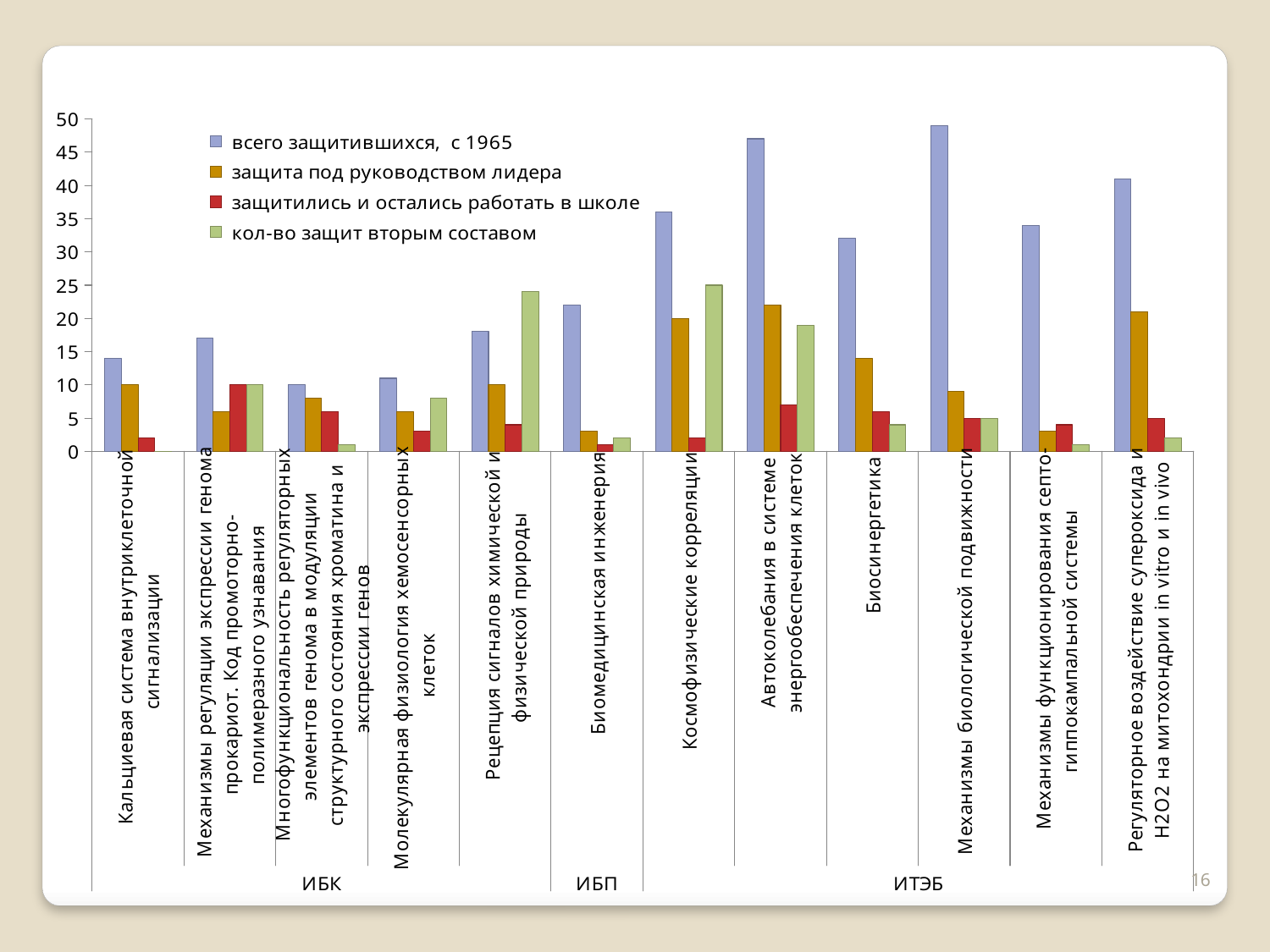
How many categories (research topics) are plotted along the x axis? 12 What is the first series listed in the legend? всего защитившихся, с 1965 Which institute groups are labelled along the bottom of the x axis? ИБК, ИБП, ИТЭБ What kind of chart is shown on the slide? bar chart Which category has the larger value of 'всего защитившихся, с 1965': Космофизические корреляции or Биосинергетика? Космофизические корреляции Is the value of 'всего защитившихся, с 1965' for Биомедицинская инженерия greater or less than 20? greater Which is larger for Рецепция сигналов химической и физической природы: 'защита под руководством лидера' or 'кол-во защит вторым составом'? кол-во защит вторым составом How many series does the legend list? 4 Which category has the larger value of 'защита под руководством лидера': Космофизические корреляции or Биосинергетика? Космофизические корреляции Is the value of 'всего защитившихся, с 1965' for Автоколебания в системе энергообеспечения клеток greater or less than 45? greater Is the value of 'всего защитившихся, с 1965' for Биосинергетика greater or less than 30? greater